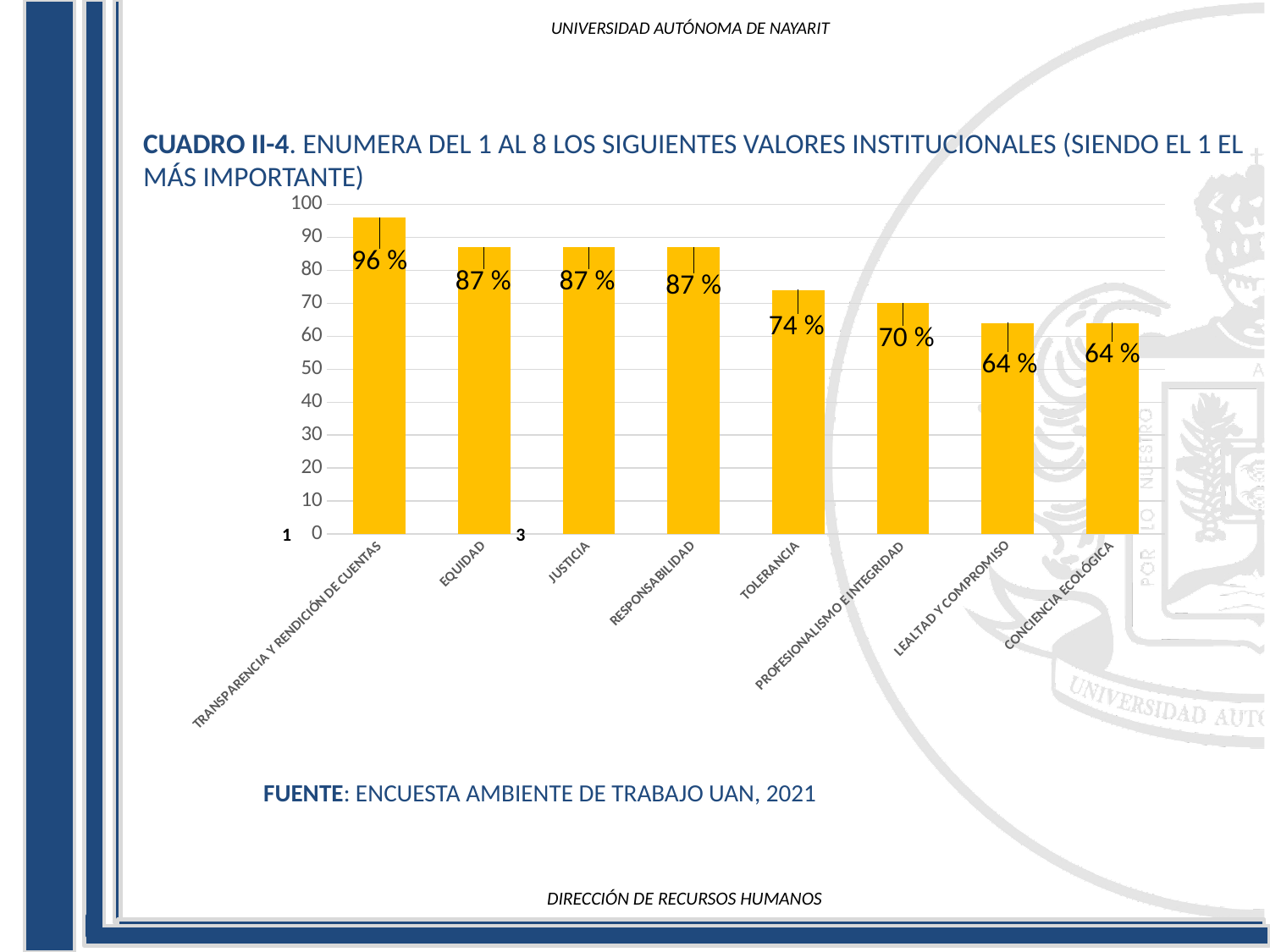
What is the source cited below the chart? ENCUESTA AMBIENTE DE TRABAJO UAN, 2021 What is the value for TOLERANCIA? 74 % How many categories are shown on the x axis? 8 What is the value for EQUIDAD? 87 % Which is larger, the value for TOLERANCIA or the value for CONCIENCIA ECOLÓGICA? TOLERANCIA What is the value for PROFESIONALISMO E INTEGRIDAD? 70 % Is the value for PROFESIONALISMO E INTEGRIDAD greater or less than 80? less What is the difference between the values for JUSTICIA and LEALTAD Y COMPROMISO? 23 % What is the value for TRANSPARENCIA Y RENDICIÓN DE CUENTAS? 96 % What kind of chart is shown on the slide? bar chart What is the difference between the values for TRANSPARENCIA Y RENDICIÓN DE CUENTAS and TOLERANCIA? 22 % Which category has the highest value? TRANSPARENCIA Y RENDICIÓN DE CUENTAS